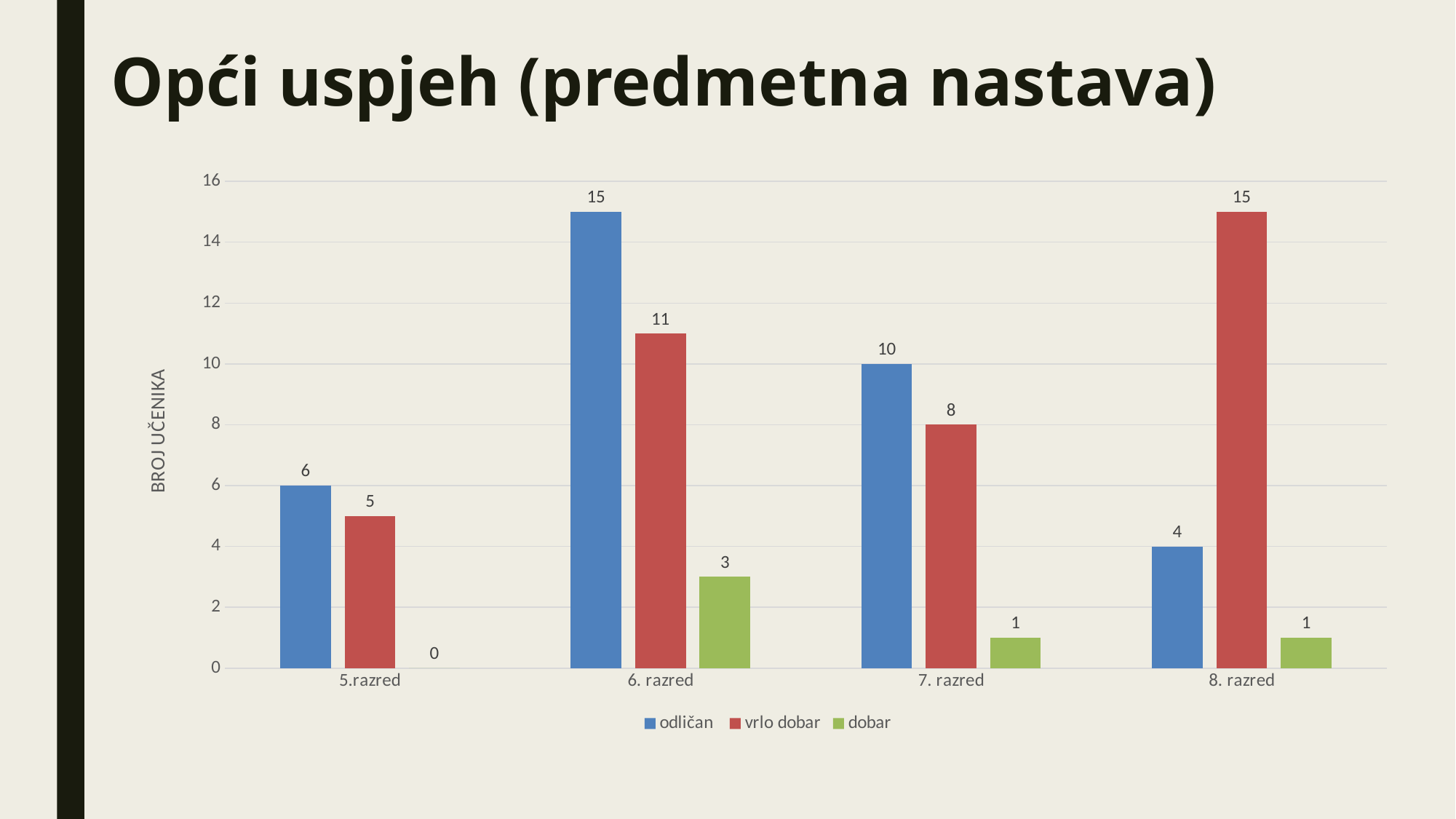
Which category has the highest value for odličan? 6. razred What kind of chart is shown on the slide? bar chart What is the value for odličan in 6. razred? 15 What is the difference between odličan and vrlo dobar in 6. razred? 4 What is the value for dobar in 5.razred? 0 Which category has the lowest value for vrlo dobar? 5.razred What is the value for vrlo dobar in 8. razred? 15 What is the value for vrlo dobar in 7. razred? 8 What is the label of the vertical axis? BROJ UČENIKA How many categories are shown on the x axis? 4 Which is larger in 8. razred, odličan or vrlo dobar? vrlo dobar How many series does the legend list? 3